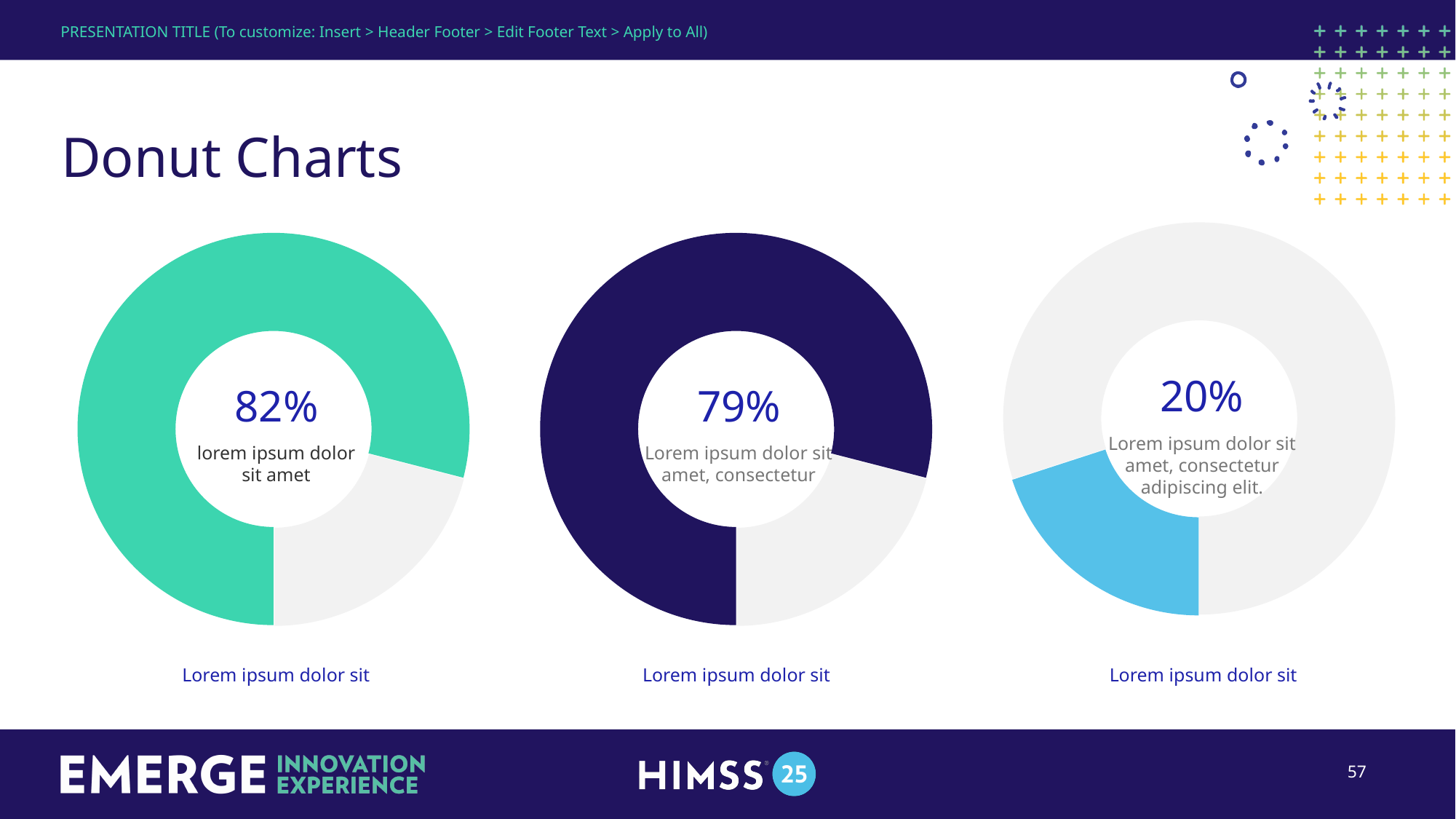
What is the difference between the percentage in the left donut chart and the percentage in the right donut chart? 62 percentage points What is the difference between the percentage in the left donut chart and the percentage in the middle donut chart? 3 percentage points Which of the three donut charts shows the highest percentage? The left chart (82%) What percentage is shown in the centre of the right donut chart? 20% What percentage is shown in the centre of the middle donut chart? 79% What colour is the highlighted segment of the right donut chart? Light blue What percentage is shown in the centre of the left donut chart? 82% How many donut charts are on the slide? 3 Which of the three donut charts shows the lowest percentage? The right chart (20%) What type of chart is used on this slide? Donut chart Which shows a larger percentage, the left donut chart or the middle donut chart? The left chart